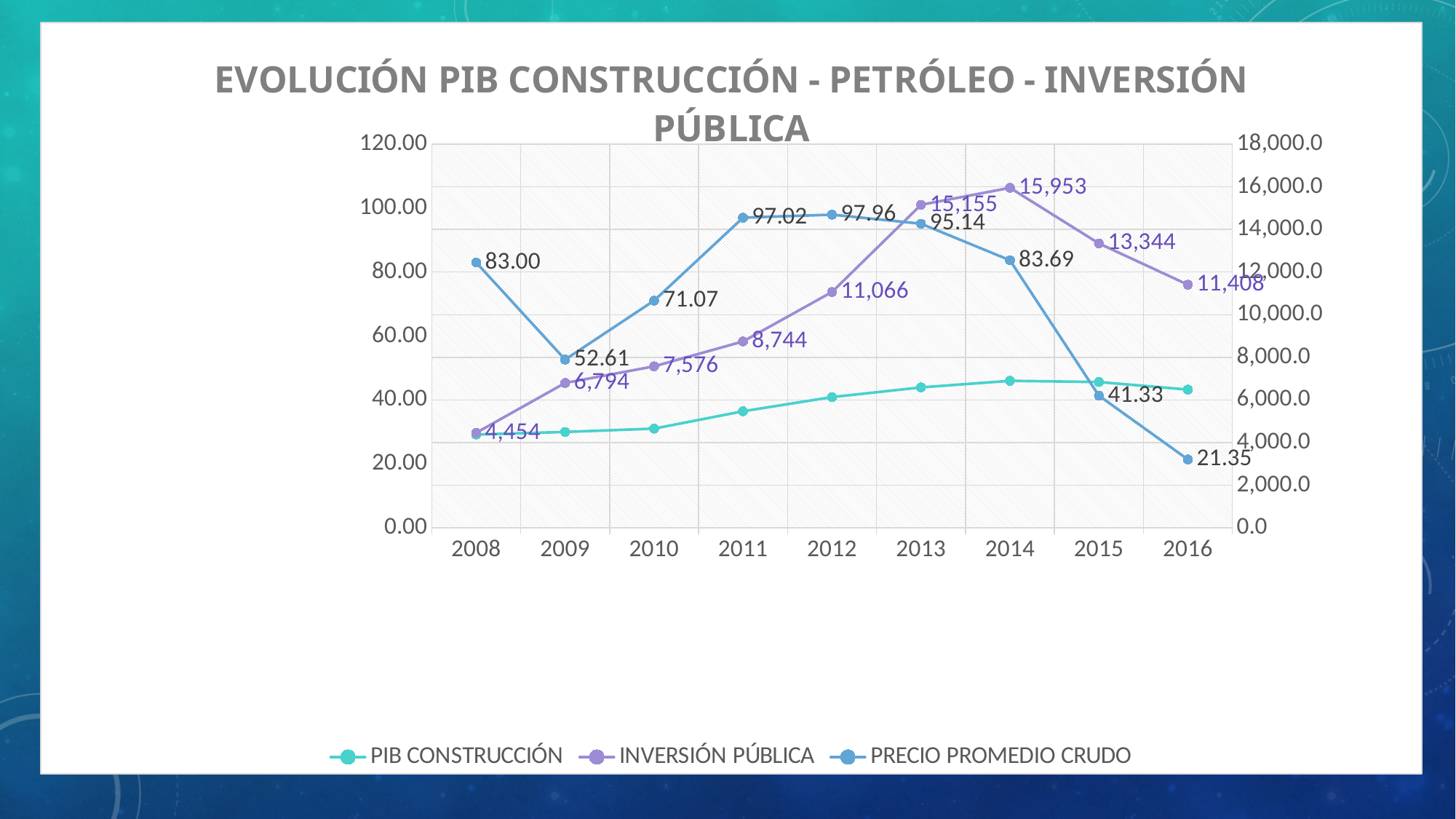
In which year is PRECIO PROMEDIO CRUDO highest? 2012 How many years are shown on the x axis? 9 What is the difference between PRECIO PROMEDIO CRUDO in 2008 and in 2009? 30.39 Does PRECIO PROMEDIO CRUDO rise or fall from 2014 to 2016? fall In which year is INVERSIÓN PÚBLICA lowest? 2008 What is the difference between INVERSIÓN PÚBLICA in 2014 and in 2015? 2,609 How many series does the legend list? 3 What is the value of PRECIO PROMEDIO CRUDO in 2008? 83.00 What is the value of INVERSIÓN PÚBLICA in 2014? 15,953 What is the value of INVERSIÓN PÚBLICA in 2008? 4,454 What is the value of PRECIO PROMEDIO CRUDO in 2016? 21.35 Which is larger, INVERSIÓN PÚBLICA in 2013 or in 2016? 2013